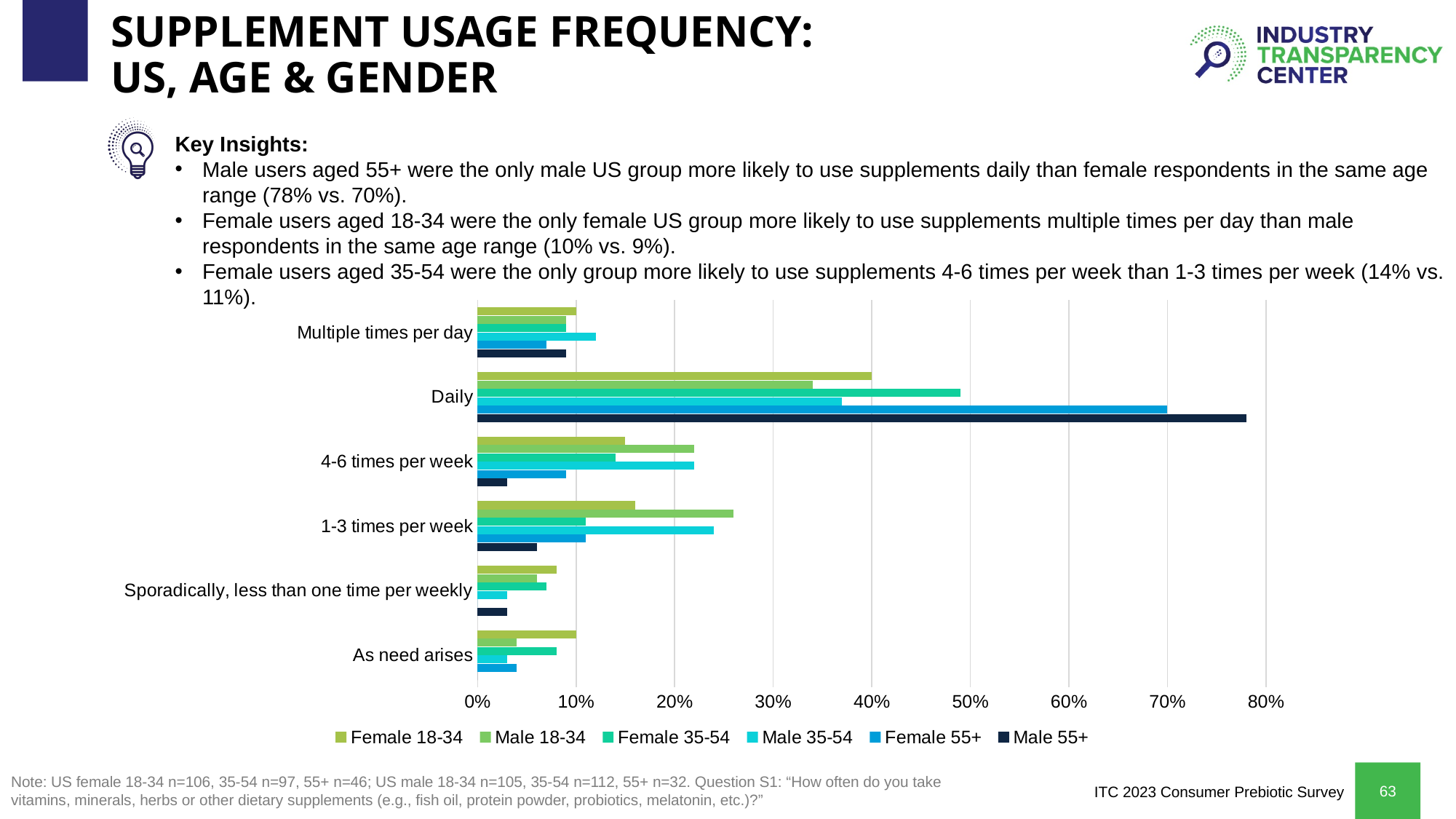
Which is larger for Daily: Female 18-34 or Male 18-34? Female 18-34 How many usage-frequency categories are shown on the chart? 6 What is the difference between the Daily values for Male 55+ and Female 55+? 8 percentage points Is the Daily value for Male 35-54 greater or less than 30%? greater Is the 4-6 times per week value for Male 55+ greater or less than 10%? less Which group has the highest value for Daily? Male 55+ What is the Daily value for Female 55+? 70% How many series does the legend list? 6 What kind of chart is shown on the slide? bar chart What is the Daily value for Male 55+? 78% What is the Daily value for Female 18-34? 40% Is the 1-3 times per week value for Male 18-34 greater or less than 20%? greater